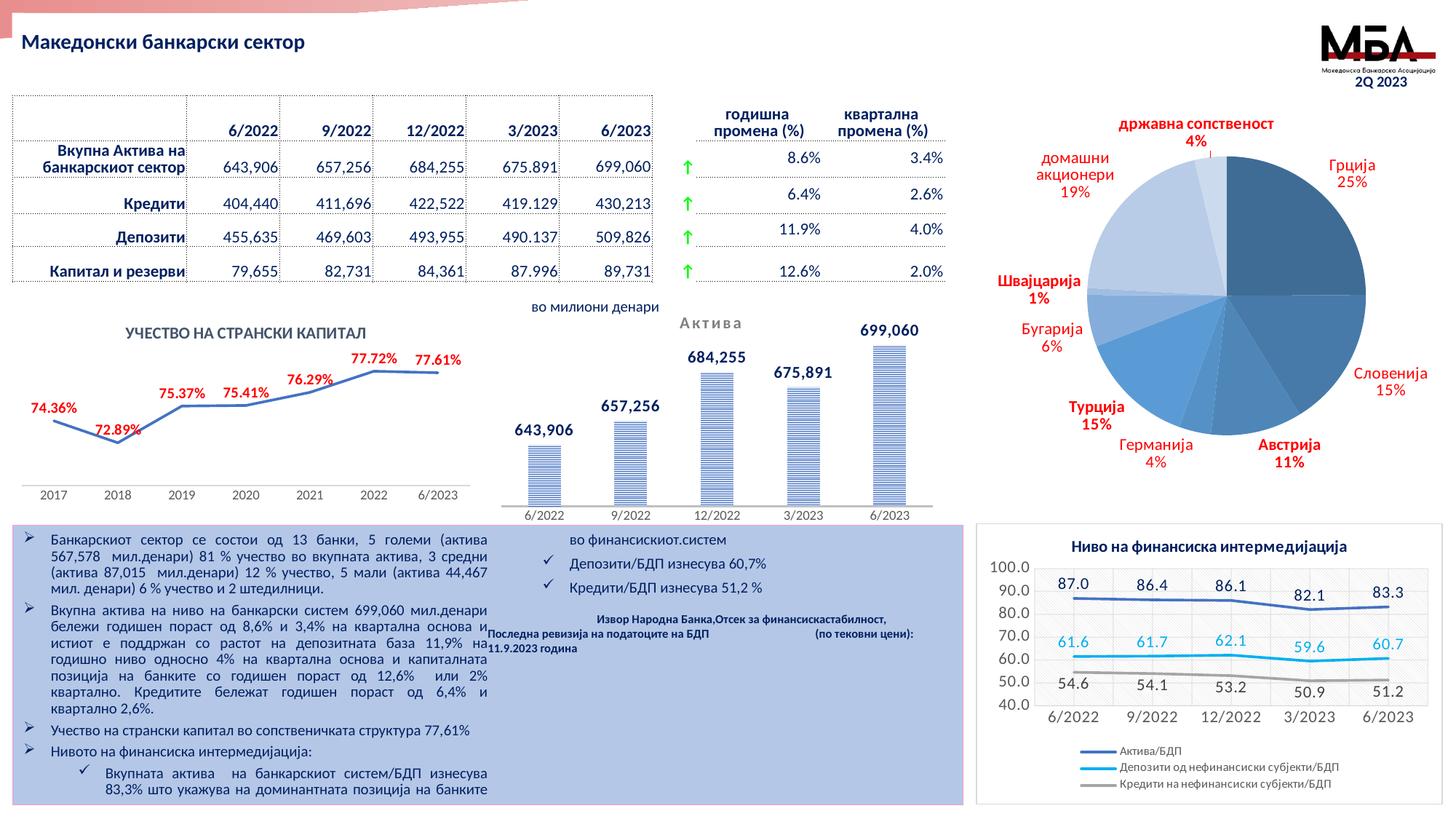
In the 'Ниво на финансиска интермедијација' chart, what is the value of Актива/БДП for 6/2023? 83.3 In the pie chart on the right, which slice is the smallest? Швајцарија In the 'УЧЕСТВО НА СТРАНСКИ КАПИТАЛ' chart, which year has the highest value? 2022 In the pie chart on the right, what share does Грција have? 25% What kind of chart is the 'Актива' chart? bar chart In the 'Актива' chart, what is the value for 12/2022? 684,255 In the 'УЧЕСТВО НА СТРАНСКИ КАПИТАЛ' chart, how many data points are plotted? 7 In the 'УЧЕСТВО НА СТРАНСКИ КАПИТАЛ' chart, what is the value for 2018? 72.89% In the pie chart on the right, which is larger: the share for Турција or the share for Австрија? Турција In the 'Актива' chart, which period has the lowest value? 6/2022 How many series does the legend of the 'Ниво на финансиска интермедијација' chart list? 3 In the 'Актива' chart, what is the difference between the values for 6/2023 and 6/2022? 55,154